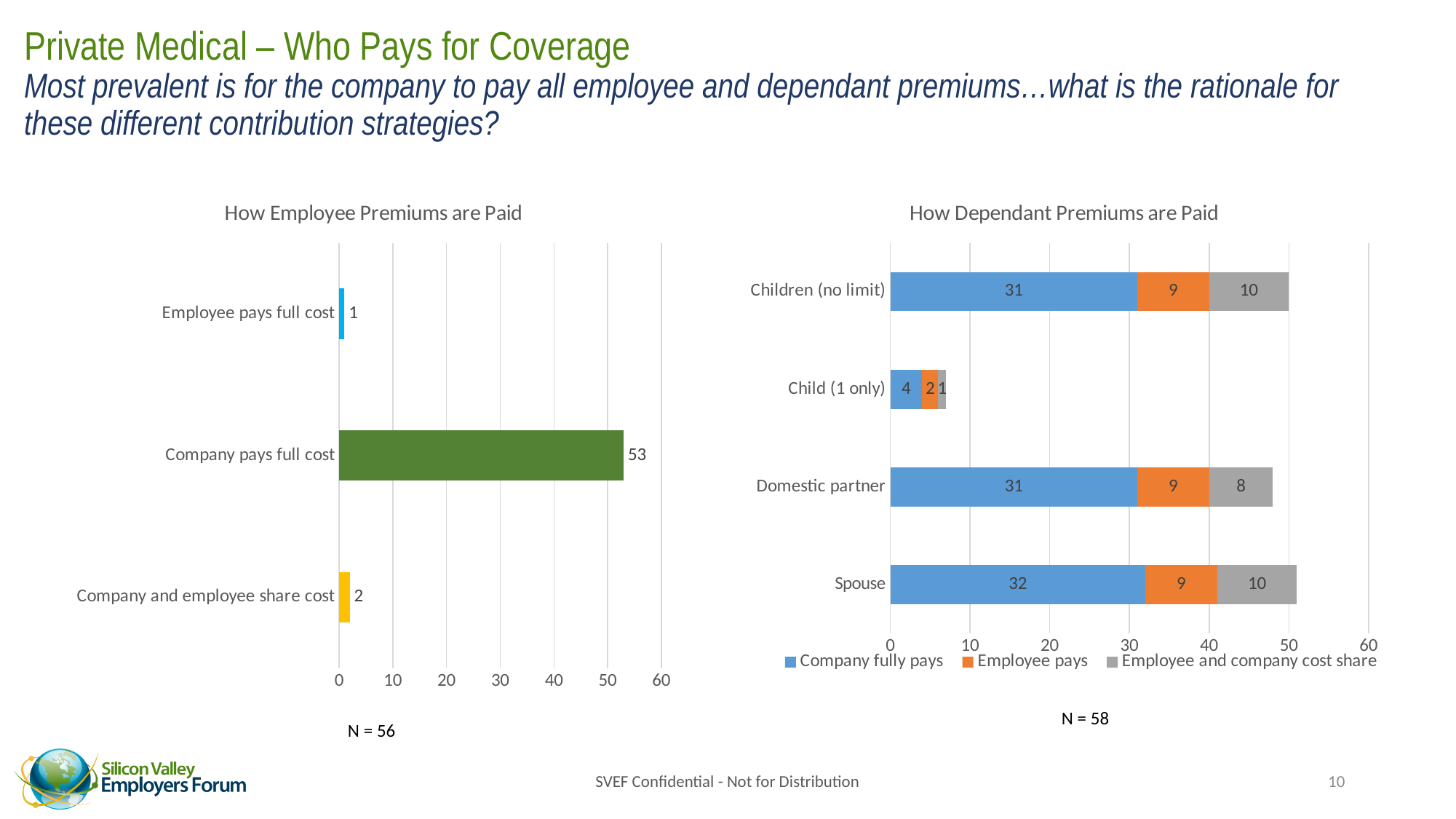
In the 'How Employee Premiums are Paid' chart, what is the difference between 'Company pays full cost' and 'Company and employee share cost'? 51 In the 'How Employee Premiums are Paid' chart, which category has the lowest value? Employee pays full cost In the 'How Employee Premiums are Paid' chart, how many categories are shown? 3 In the 'How Dependant Premiums are Paid' chart, which is larger: the 'Company fully pays' value for 'Spouse' or for 'Child (1 only)'? Spouse What kind of chart is 'How Dependant Premiums are Paid'? Stacked bar chart In the 'How Dependant Premiums are Paid' chart, what is the total of the 'Children (no limit)' bar? 50 In the 'How Dependant Premiums are Paid' chart, what is the 'Employee and company cost share' value for 'Domestic partner'? 8 In the 'How Dependant Premiums are Paid' chart, what is the 'Company fully pays' value for 'Spouse'? 32 In the 'How Dependant Premiums are Paid' chart, how many series does the legend list? 3 In the 'How Employee Premiums are Paid' chart, what is the value for 'Company pays full cost'? 53 In the 'How Dependant Premiums are Paid' chart, what is the total of the 'Child (1 only)' bar? 7 In the 'How Dependant Premiums are Paid' chart, which colour represents 'Employee pays'? Orange